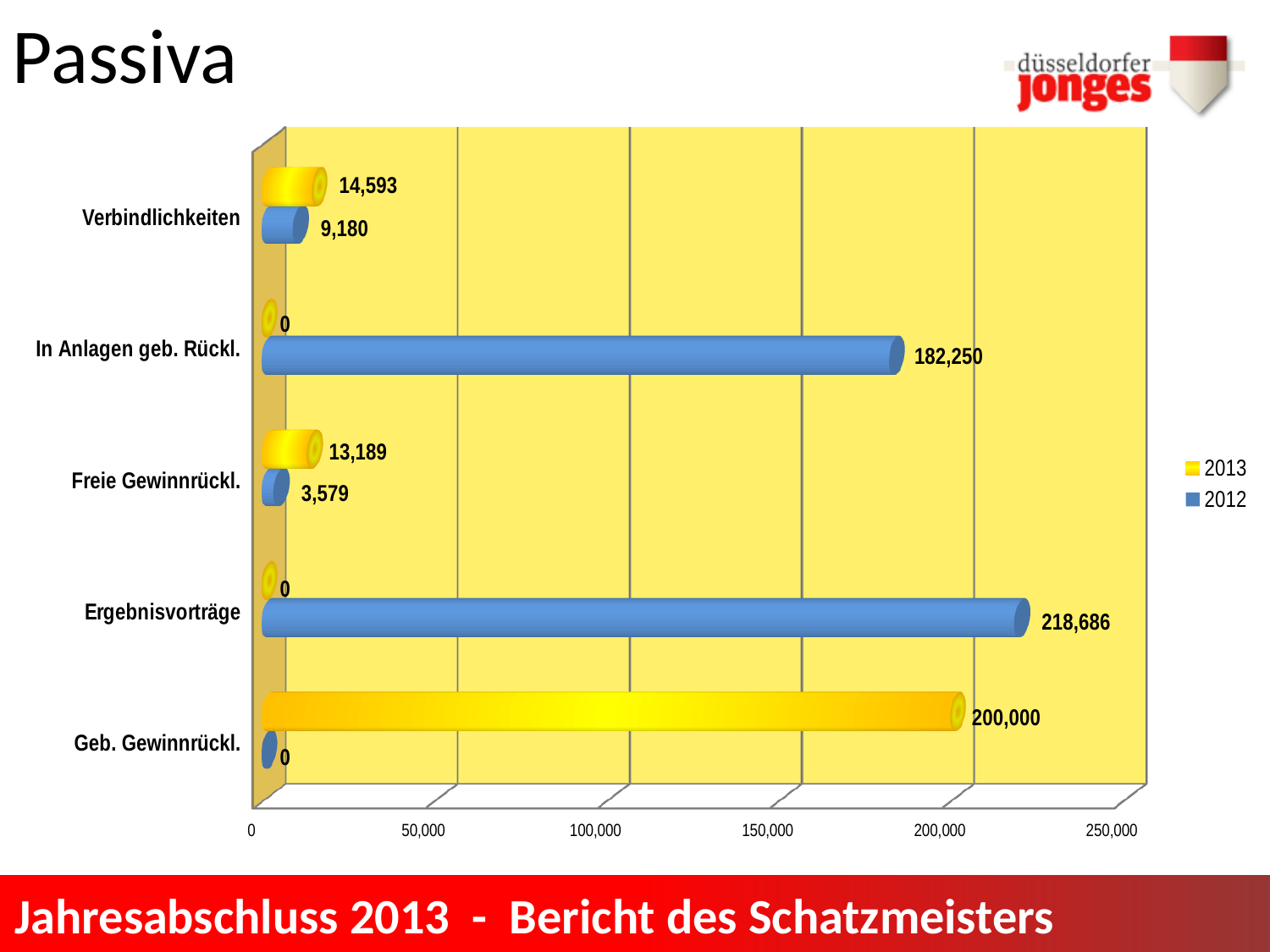
Which category has the highest 2012 value? Ergebnisvorträge What is the 2012 value for Freie Gewinnrückl.? 3,579 How many series does the legend list? 2 What is the 2012 value for In Anlagen geb. Rückl.? 182,250 Which is larger for Freie Gewinnrückl., the 2013 value or the 2012 value? 2013 What is the 2013 value for Verbindlichkeiten? 14,593 Which category has the highest 2013 value? Geb. Gewinnrückl. What is the difference between the 2013 and 2012 values for Verbindlichkeiten? 5,413 What is the 2013 value for Geb. Gewinnrückl.? 200,000 What is the 2012 value for Ergebnisvorträge? 218,686 How many categories are shown on the chart? 5 What is the difference between the 2013 and 2012 values for Freie Gewinnrückl.? 9,610